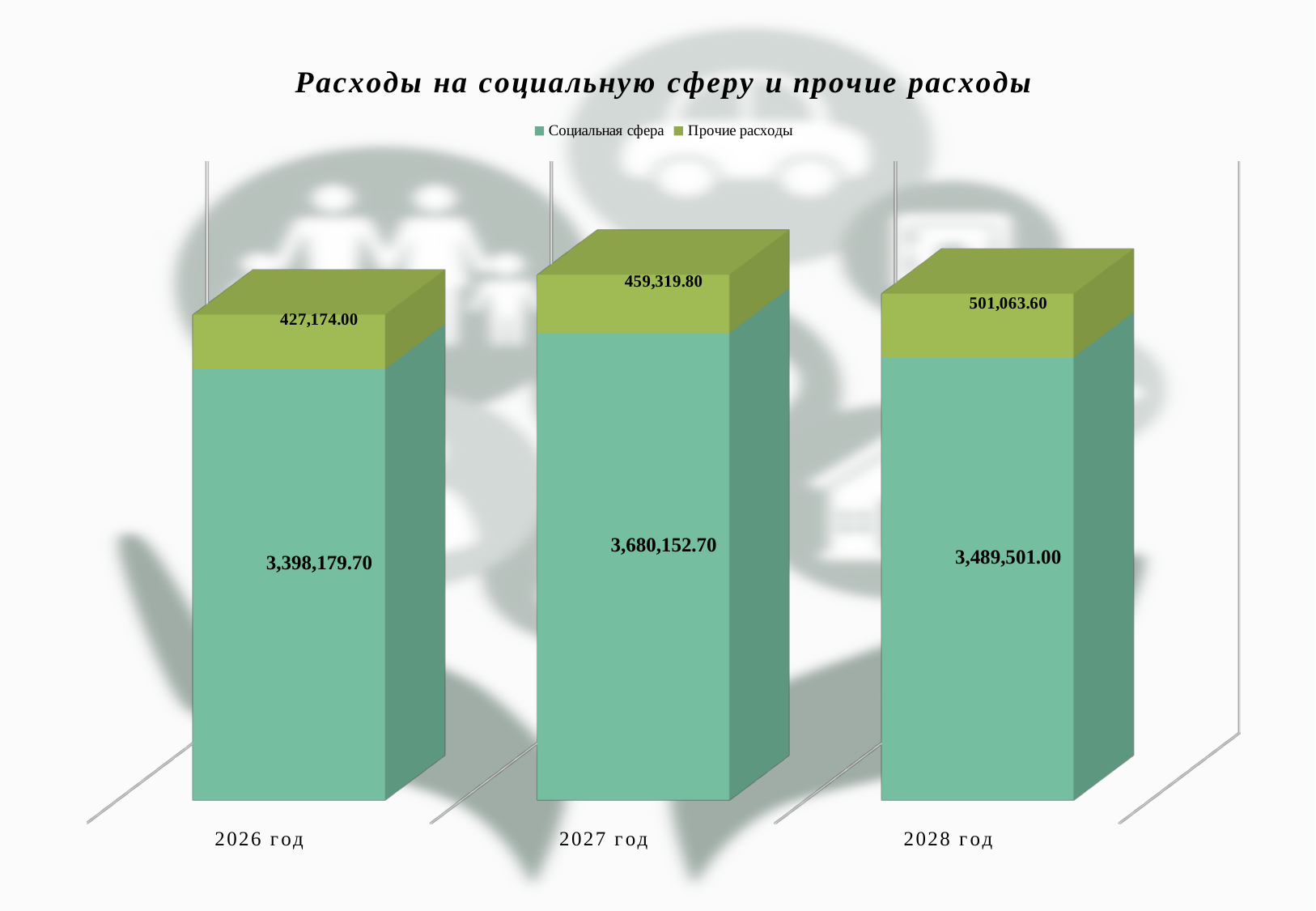
What is the total of the stacked bar for 2027 год? 4,139,472.50 What kind of chart is shown on the slide? Stacked bar chart What is the difference between the Прочие расходы values for 2028 год and 2027 год? 41,743.80 Which is larger: Социальная сфера in 2028 год or Социальная сфера in 2026 год? 2028 год What is the value for Прочие расходы in 2028 год? 501,063.60 How many series does the legend list? 2 What is the difference between the Социальная сфера values for 2027 год and 2026 год? 281,973.00 Which year has the lowest value for Прочие расходы? 2026 год What is the value for Прочие расходы in 2027 год? 459,319.80 How many years are shown on the x axis? 3 What is the value for Социальная сфера in 2026 год? 3,398,179.70 Which year has the highest value for Социальная сфера? 2027 год